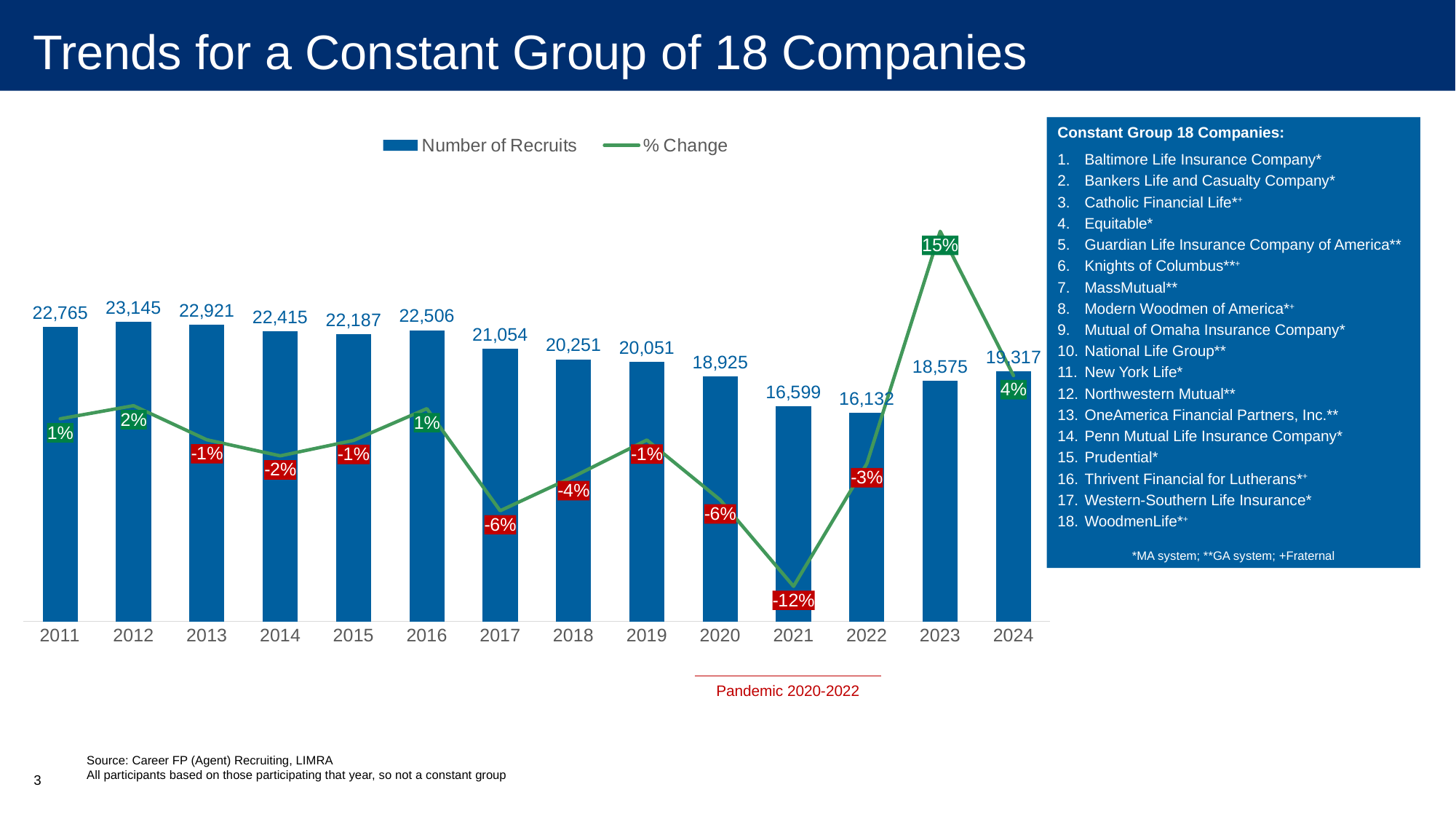
What is the overall trend in Number of Recruits from 2016 to 2022? Falling What is the % Change shown for 2021? -12% What is the Number of Recruits for 2024? 19,317 Which year has more recruits, 2017 or 2020? 2017 How many series does the chart legend list? 2 What is the difference in Number of Recruits between 2012 and 2022? 7,013 Which year has the lowest Number of Recruits? 2022 Which year has the highest Number of Recruits? 2012 What is the difference in Number of Recruits between 2024 and 2023? 742 Which year has the highest % Change? 2023 What is the Number of Recruits for 2012? 23,145 How many years are shown on the x axis of the chart? 14